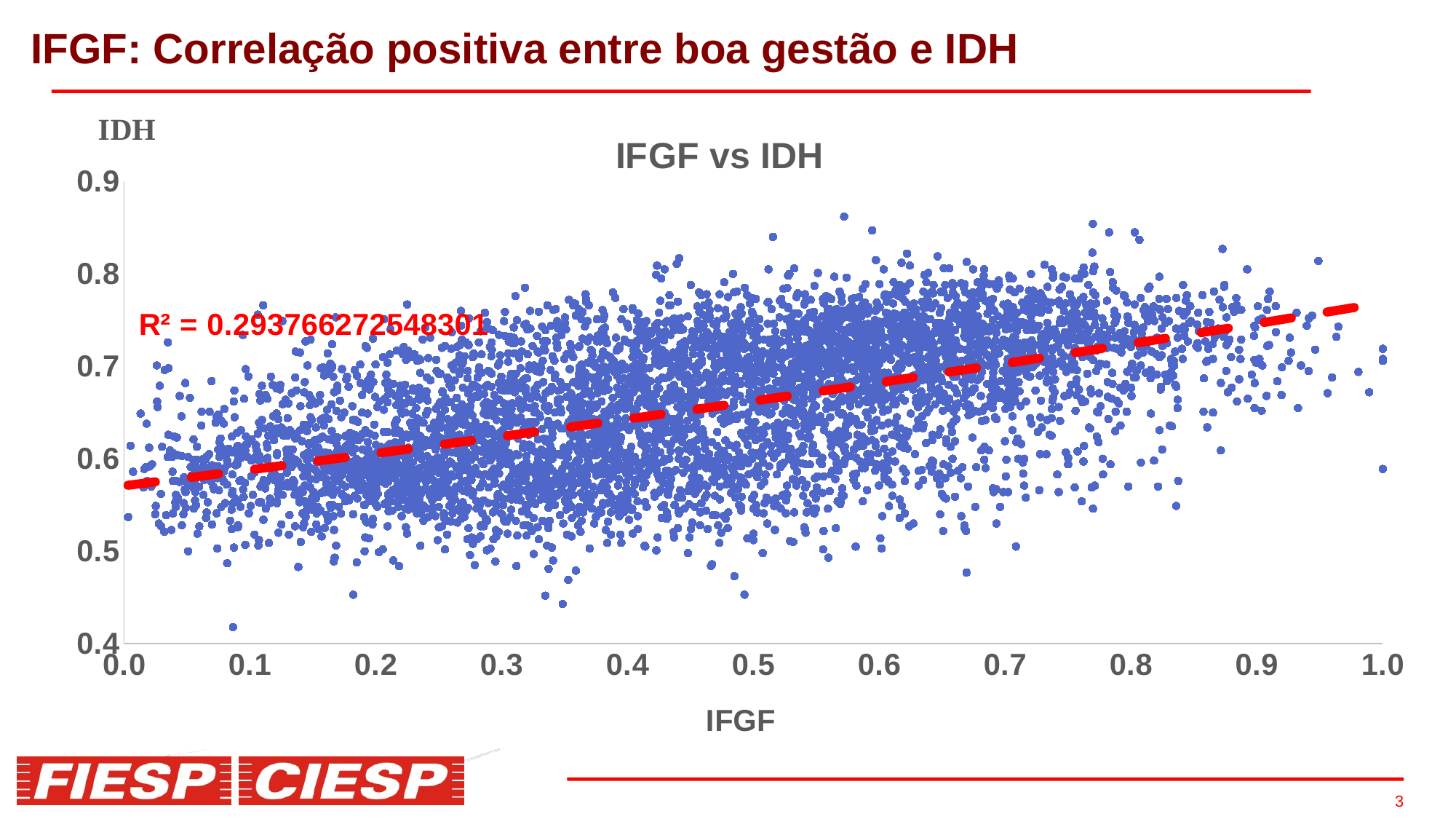
What kind of chart is shown on the slide? Scatter plot Is the value of the dashed trendline at IFGF 0.0 greater or less than 0.6? less What is the highest value shown on the x axis (IFGF)? 1.0 What is the lowest value shown on the y axis (IDH)? 0.4 What is the highest value shown on the y axis (IDH)? 0.9 Is the IDH value of the highest plotted point greater or less than 0.8? greater Does the dashed trendline rise or fall as IFGF increases from 0.0 to 1.0? Rises What variable is plotted on the x axis of the chart? IFGF Is the IDH value of the lowest plotted point greater or less than 0.5? less What is the title of the chart? IFGF vs IDH What is the R² value printed on the chart? R² = 0.293766272548301